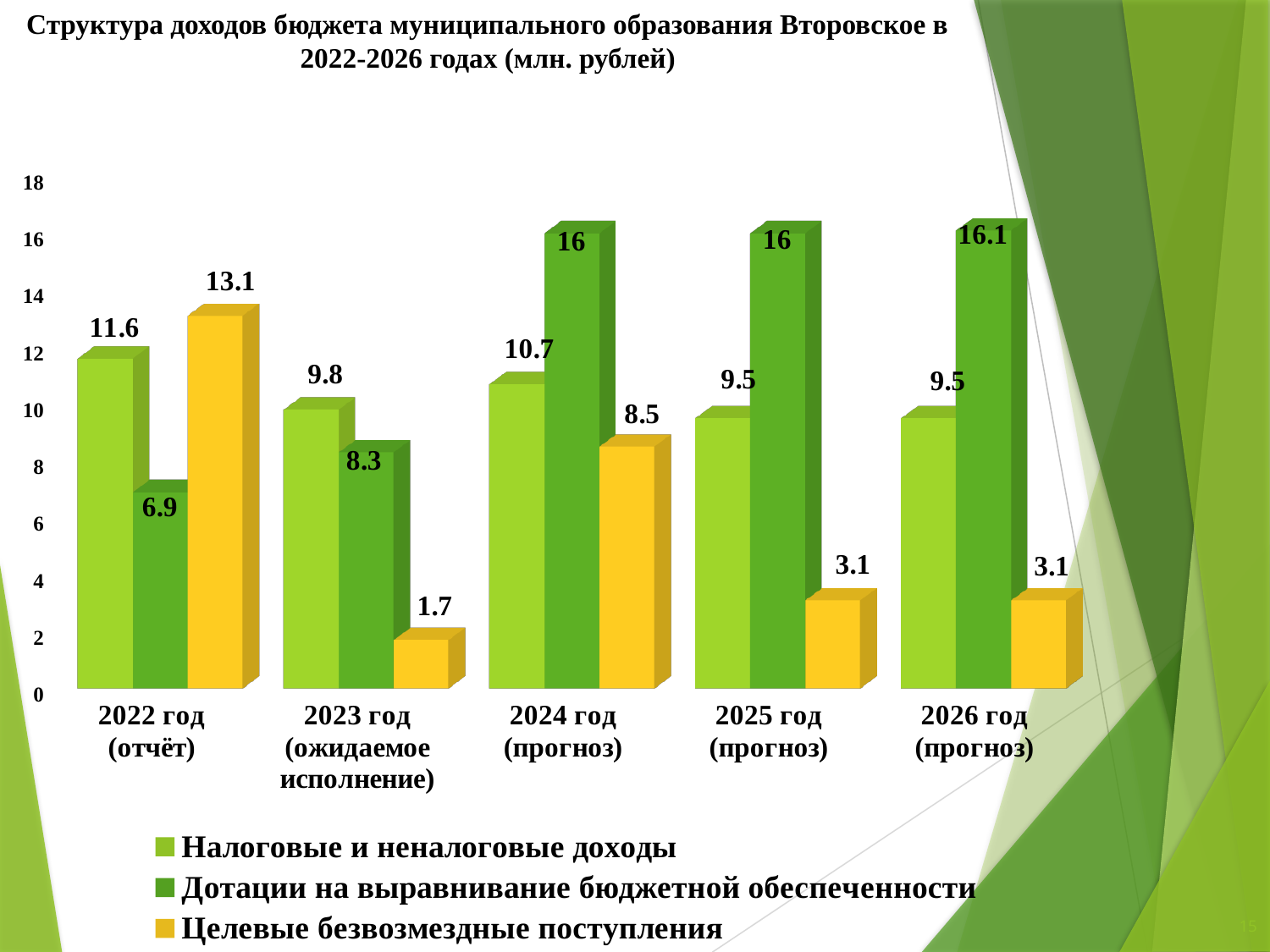
How many series does the legend list? 3 Which is larger in 2023 год (ожидаемое исполнение): Налоговые и неналоговые доходы or Дотации на выравнивание бюджетной обеспеченности? Налоговые и неналоговые доходы What kind of chart is shown on the slide? Bar chart In which year is Целевые безвозмездные поступления highest? 2022 год (отчёт) What is the total of the three series for 2025 год (прогноз)? 28.6 What is the value of Целевые безвозмездные поступления for 2023 год (ожидаемое исполнение)? 1.7 What is the value of Дотации на выравнивание бюджетной обеспеченности for 2026 год (прогноз)? 16.1 How many year categories are shown on the x axis? 5 Does Целевые безвозмездные поступления rise or fall from 2022 год to 2023 год? Fall In which year is Дотации на выравнивание бюджетной обеспеченности lowest? 2022 год (отчёт) What is the difference between Налоговые и неналоговые доходы and Дотации на выравнивание бюджетной обеспеченности in 2024 год (прогноз)? 5.3 What is the value of Налоговые и неналоговые доходы for 2022 год (отчёт)? 11.6